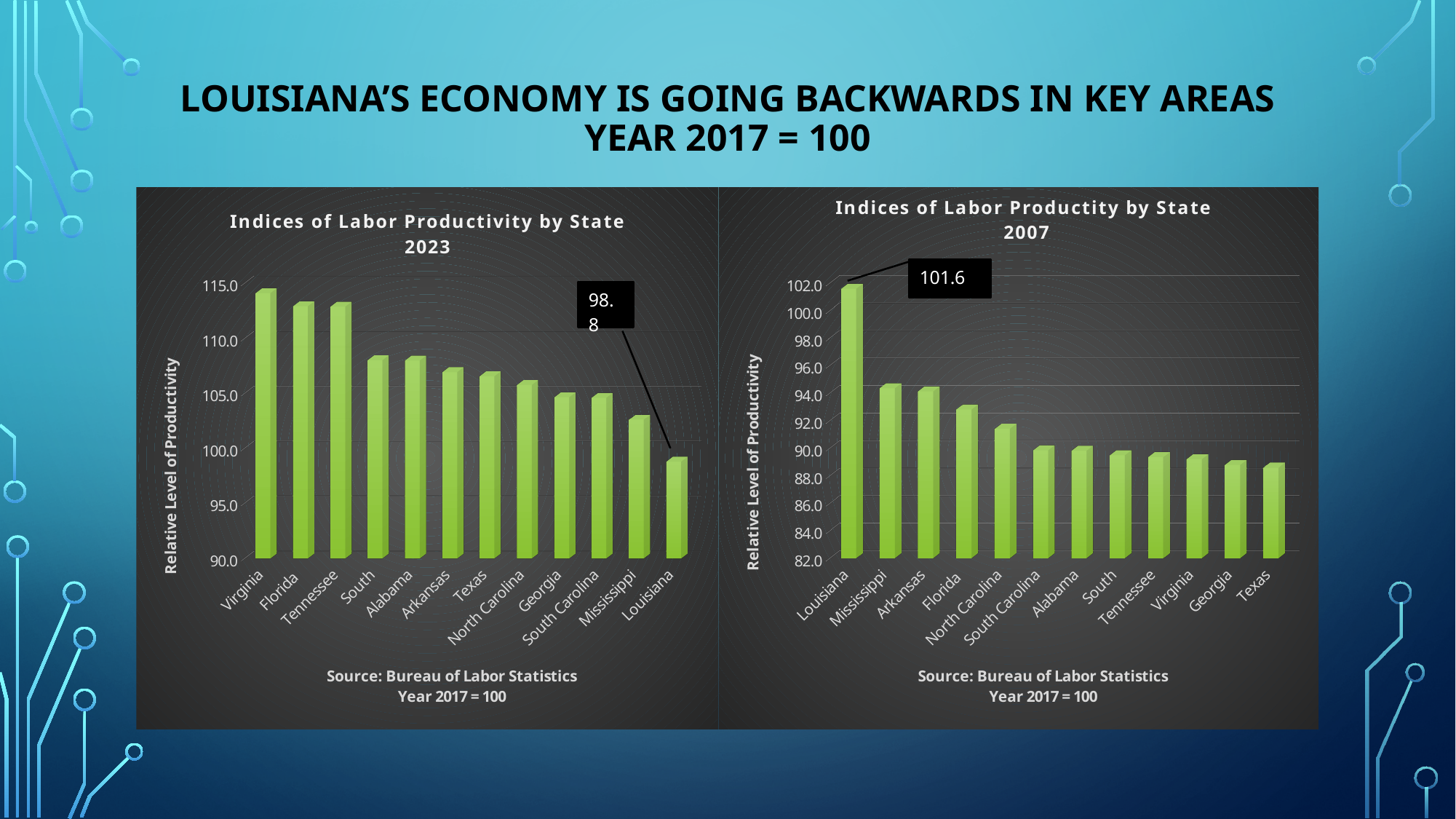
How many states are shown in the 2007 chart (right)? 12 What type of chart is the 2023 chart on the left? Bar chart In the 2023 chart (left), which state has the highest labor productivity index? Virginia In the 2023 chart (left), which state has the lowest labor productivity index? Louisiana What is the difference between Louisiana's labeled value in the 2007 chart and its labeled value in the 2023 chart? 2.8 In the 2023 chart (left), is the value for Mississippi greater or less than 100? greater In the 2023 chart (left), is the value for Virginia greater or less than 110? greater In the 2007 chart (right), is the value for Texas greater or less than 90? less In the 2007 chart (right), do the values rise or fall from left to right along the x axis? Fall In the 2007 chart (right), which state has the highest labor productivity index? Louisiana In the 2023 chart (left), what is the labeled value for Louisiana? 98.8 In the 2007 chart (right), what is the labeled value for Louisiana? 101.6